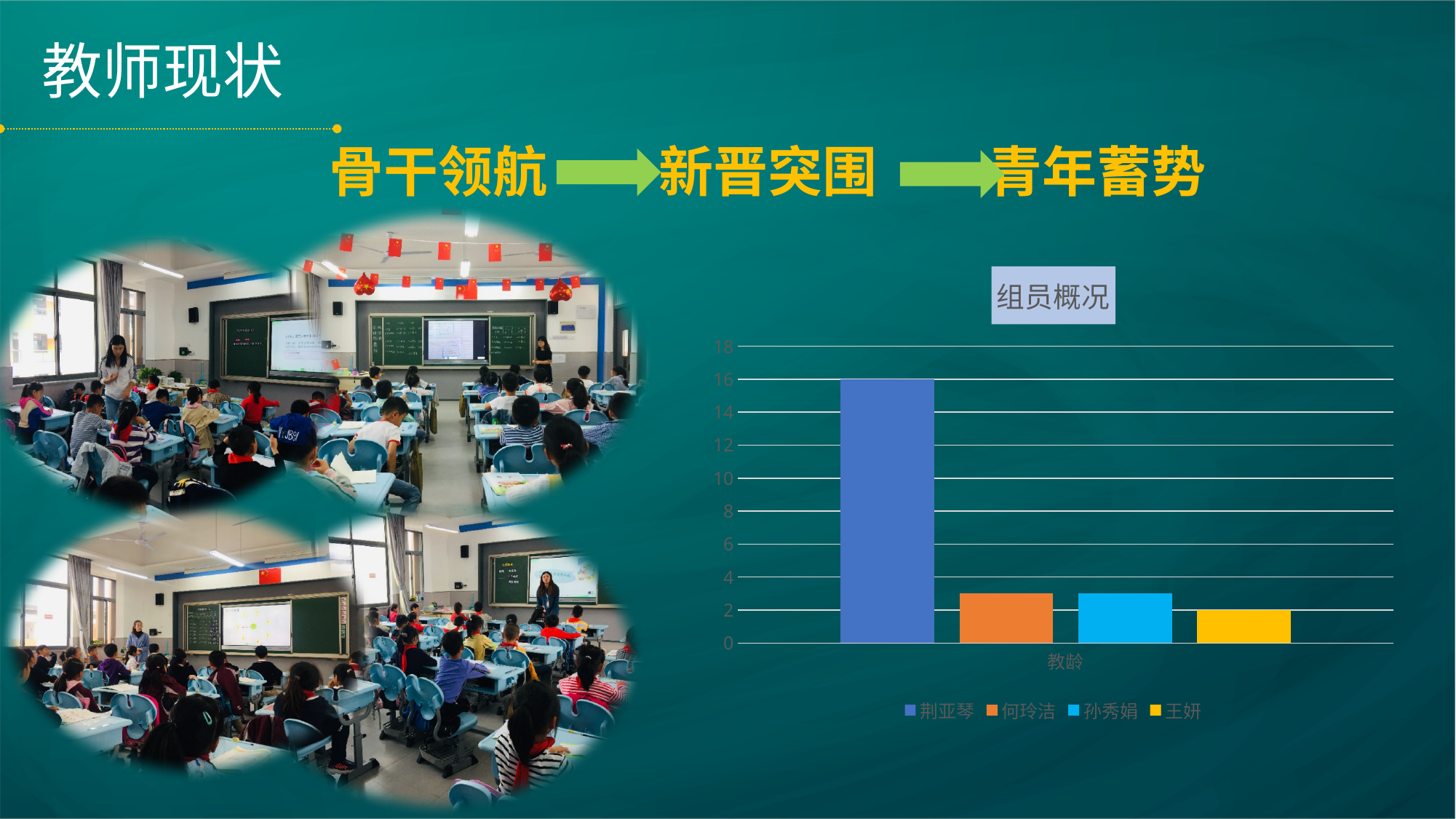
What is the category label on the x axis of the chart? 教龄 How many categories are shown on the x axis of the chart? 1 Which series has the lowest value in the chart? 王妍 How many series does the chart legend list? 4 What is the difference between the value for 荆亚琴 and the value for 王妍? 14 What kind of chart is shown under the title 组员概况? bar chart Which series has the highest value in the chart? 荆亚琴 Which is larger, the value for 荆亚琴 or the value for 何玲洁? 荆亚琴 What is the value for 王妍 in the chart? 2 What is the title of the chart on the slide? 组员概况 What is the value for 荆亚琴 in the chart? 16 Is the value for 孙秀娟 greater or less than 4? less